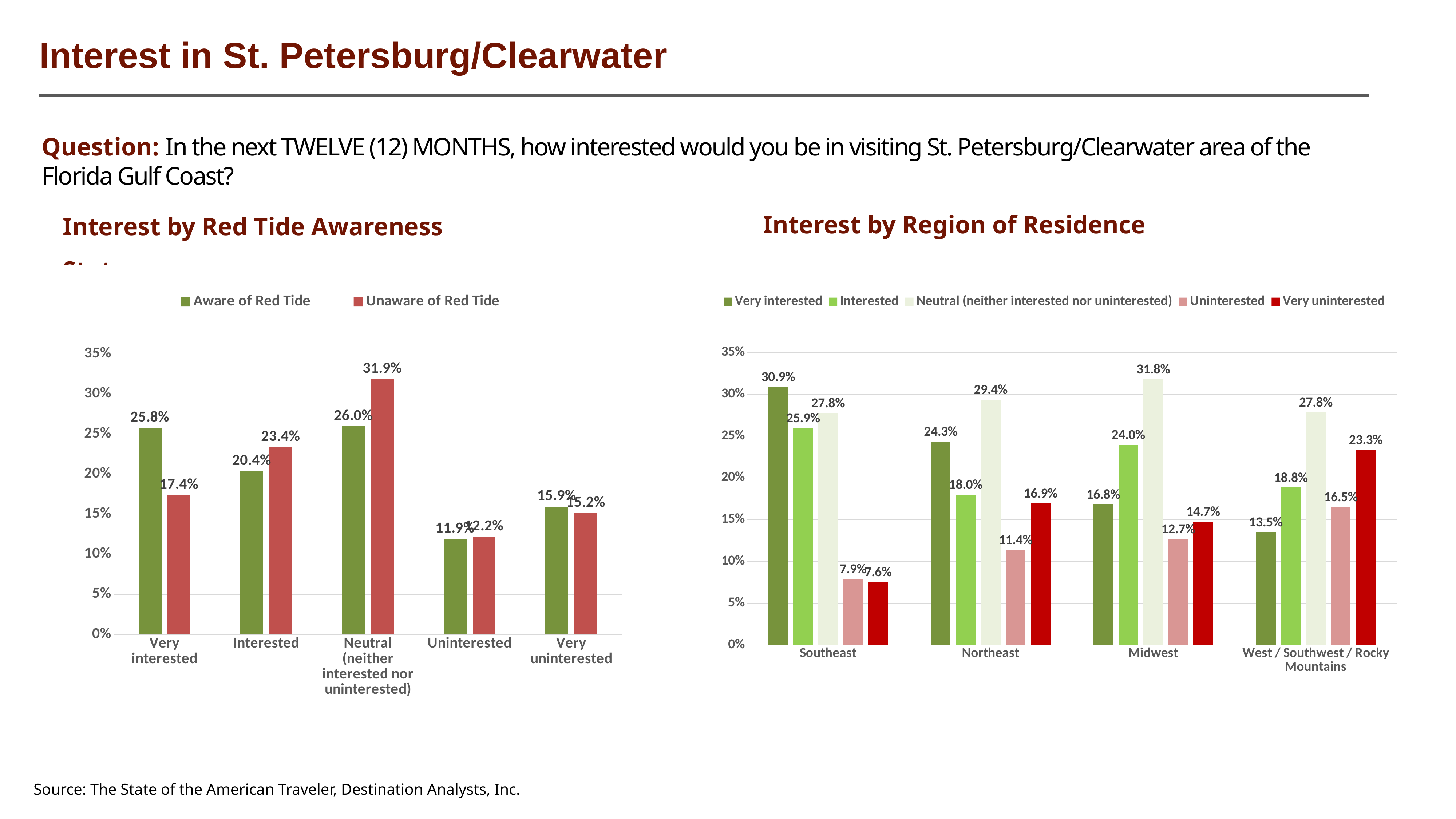
In the Interest by Region of Residence chart, which region has the highest value for Neutral (neither interested nor uninterested)? Midwest In the Interest by Red Tide Awareness chart, what is the value for Unaware of Red Tide in the Neutral (neither interested nor uninterested) category? 31.9% In the Interest by Red Tide Awareness chart, what is the difference between Aware of Red Tide and Unaware of Red Tide in the Very interested category? 8.4% What kind of chart is the Interest by Region of Residence chart? Bar chart In the Interest by Red Tide Awareness chart, which category has the lowest value for Aware of Red Tide? Uninterested In the Interest by Region of Residence chart, what is the value for Very uninterested in the West / Southwest / Rocky Mountains? 23.3% In the Interest by Region of Residence chart, what is the value for Very interested in the Southeast? 30.9% In the Interest by Red Tide Awareness chart, how many series does the legend list? 2 In the Interest by Red Tide Awareness chart, what is the value for Aware of Red Tide in the Very interested category? 25.8% In the Interest by Region of Residence chart, which is larger: Very interested in the Northeast or Very interested in the Midwest? Northeast In the Interest by Region of Residence chart, how many series does the legend list? 5 In the Interest by Region of Residence chart, how many regions are shown on the x axis? 4